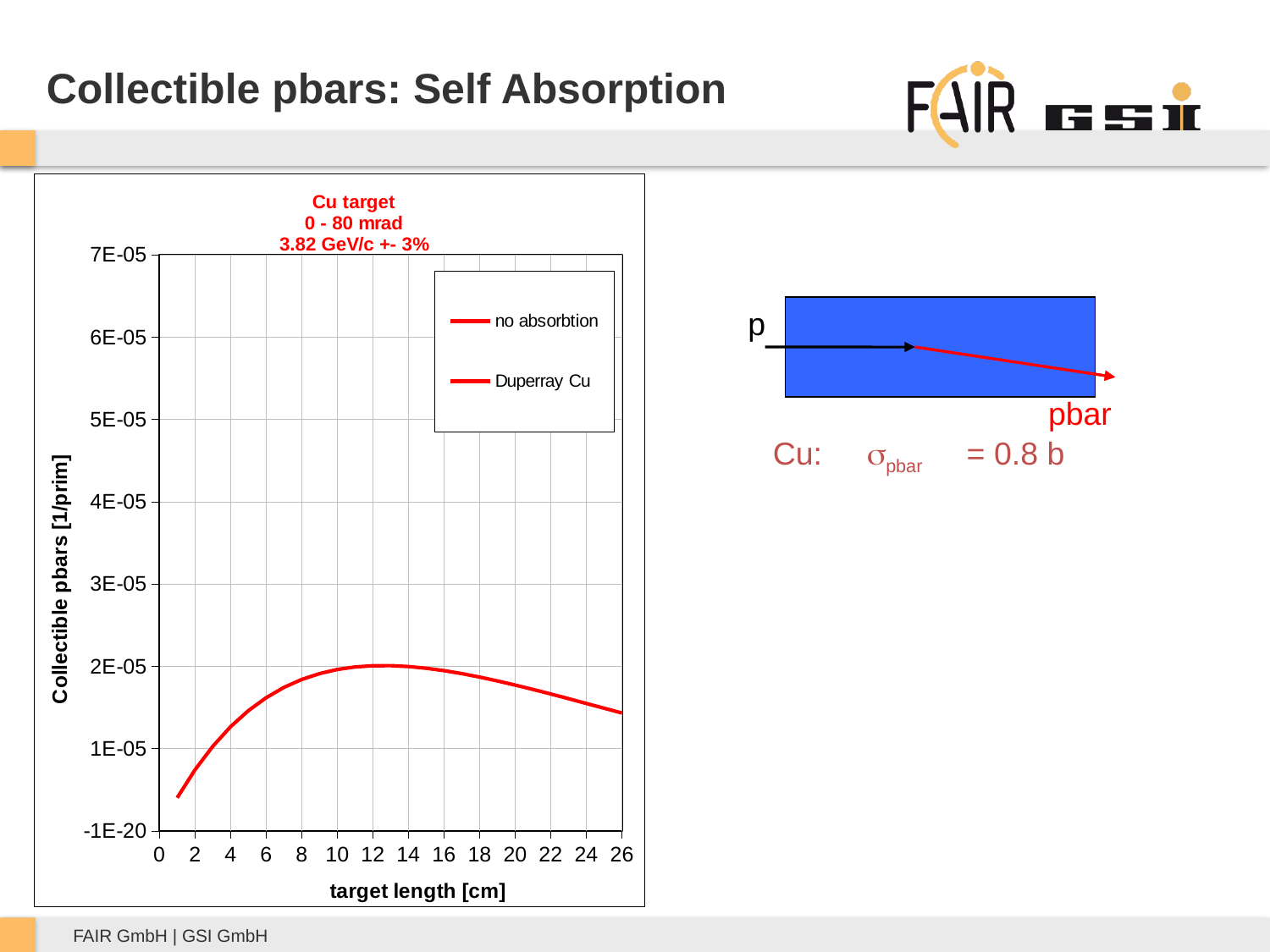
Is the value of the curve at a target length of 2 cm greater or less than 1E-05? less Which is larger, the value of the curve at 12 cm or at 26 cm? 12 cm What is the label of the x axis of the chart? target length [cm] What is the label of the y axis of the chart? Collectible pbars [1/prim] What is the highest tick value shown on the x axis of the chart? 26 How many series does the chart legend list? 2 Does the curve rise or fall between target lengths of 16 cm and 26 cm? fall What kind of chart is shown on the slide? line chart Does the curve rise or fall between target lengths of 2 cm and 10 cm? rise Is the maximum value reached by the curve greater or less than 3E-05? less Is the value of the curve at a target length of 12 cm greater or less than 1E-05? greater